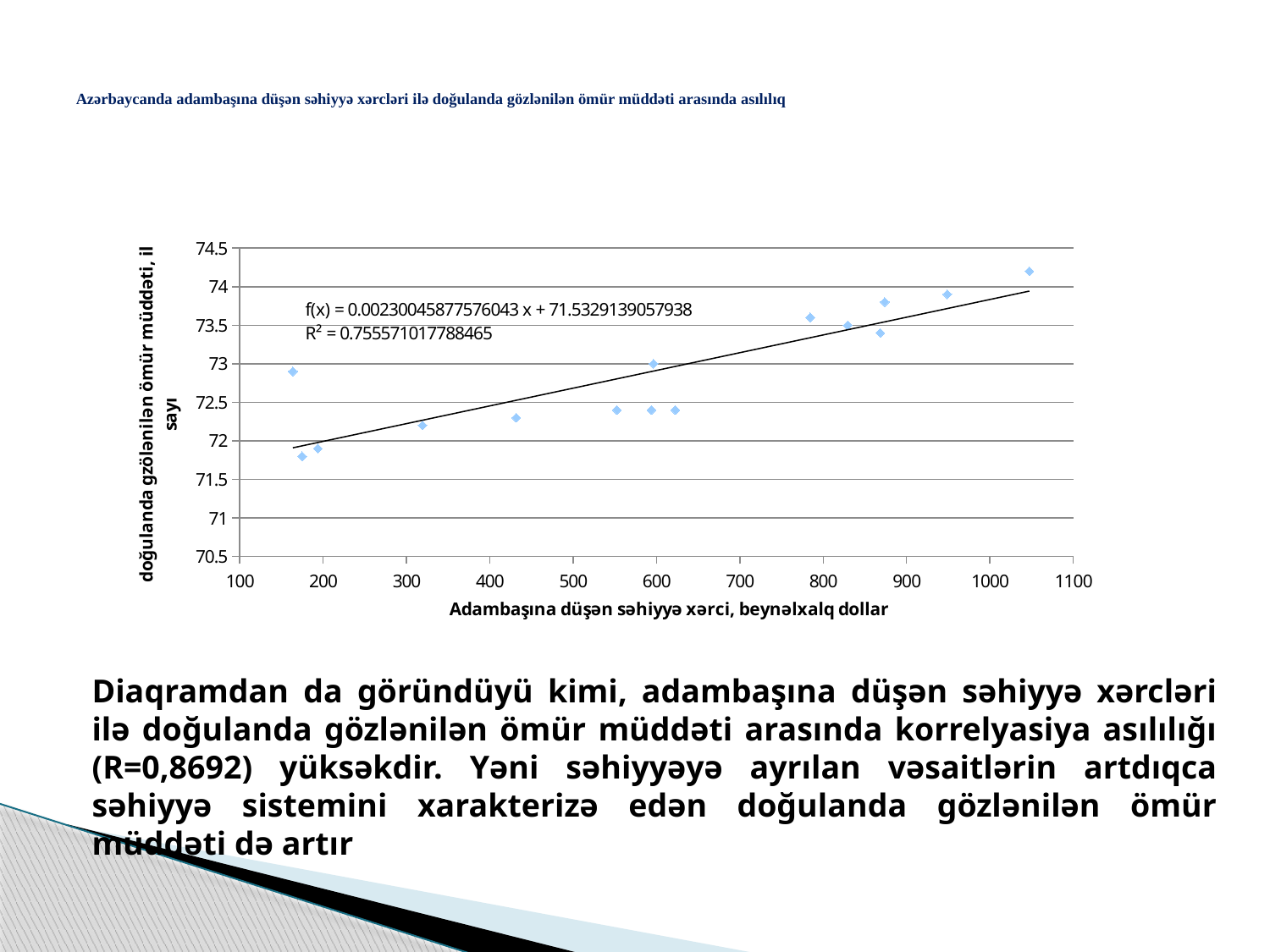
Is the life expectancy value for the point at about 430 international dollars greater or less than 72.5? less What is the highest value shown on the x axis? 1100 What is the R² value printed on the chart? R² = 0.755571017788465 What is the trendline equation printed on the chart? f(x) = 0.00230045877576043 x + 71.5329139057938 What kind of chart is shown on the slide? scatter chart Which point has the highest life expectancy: the one at about 1050 international dollars or the one at about 165 international dollars? the one at about 1050 international dollars Is the life expectancy value for the point at about 950 international dollars greater or less than 73.5? greater Is the life expectancy value for the rightmost point (around 1050 international dollars) greater or less than 74? greater Do the plotted values generally rise or fall as per-capita health spending increases along the x axis? rise